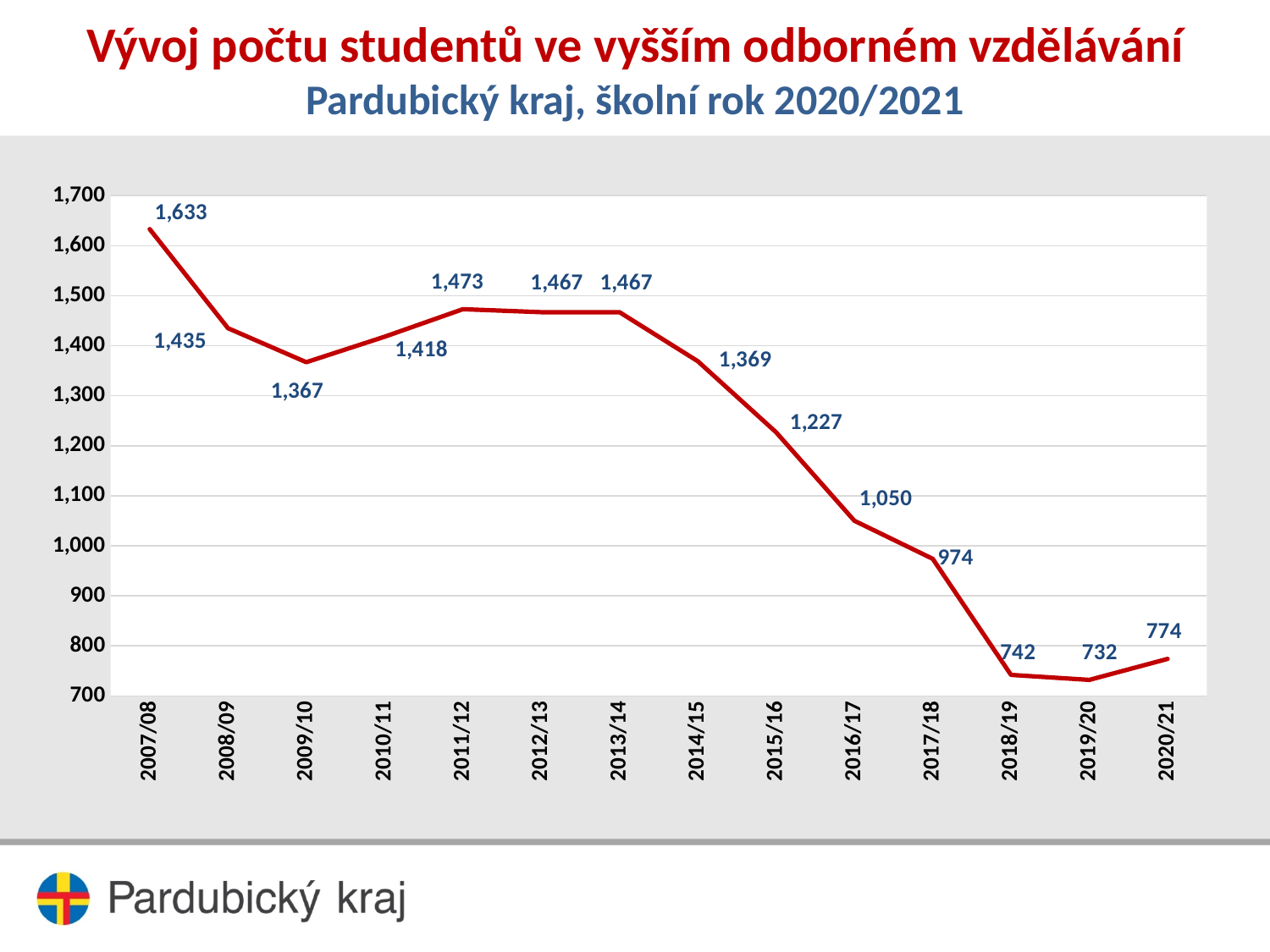
What is the number of students in 2007/08? 1,633 What is the number of students in 2015/16? 1,227 What is the number of students in 2011/12? 1,473 Which is larger, the value for 2009/10 or the value for 2010/11? 2010/11 What type of chart is shown on the slide? line chart Do the values generally rise or fall from 2013/14 to 2019/20? fall What is the number of students in 2020/21? 774 Which school year has the highest number of students? 2007/08 Which school year has the lowest number of students? 2019/20 What is the difference between the number of students in 2007/08 and 2020/21? 859 What is the difference between the number of students in 2016/17 and 2017/18? 76 How many school years are plotted on the x axis? 14